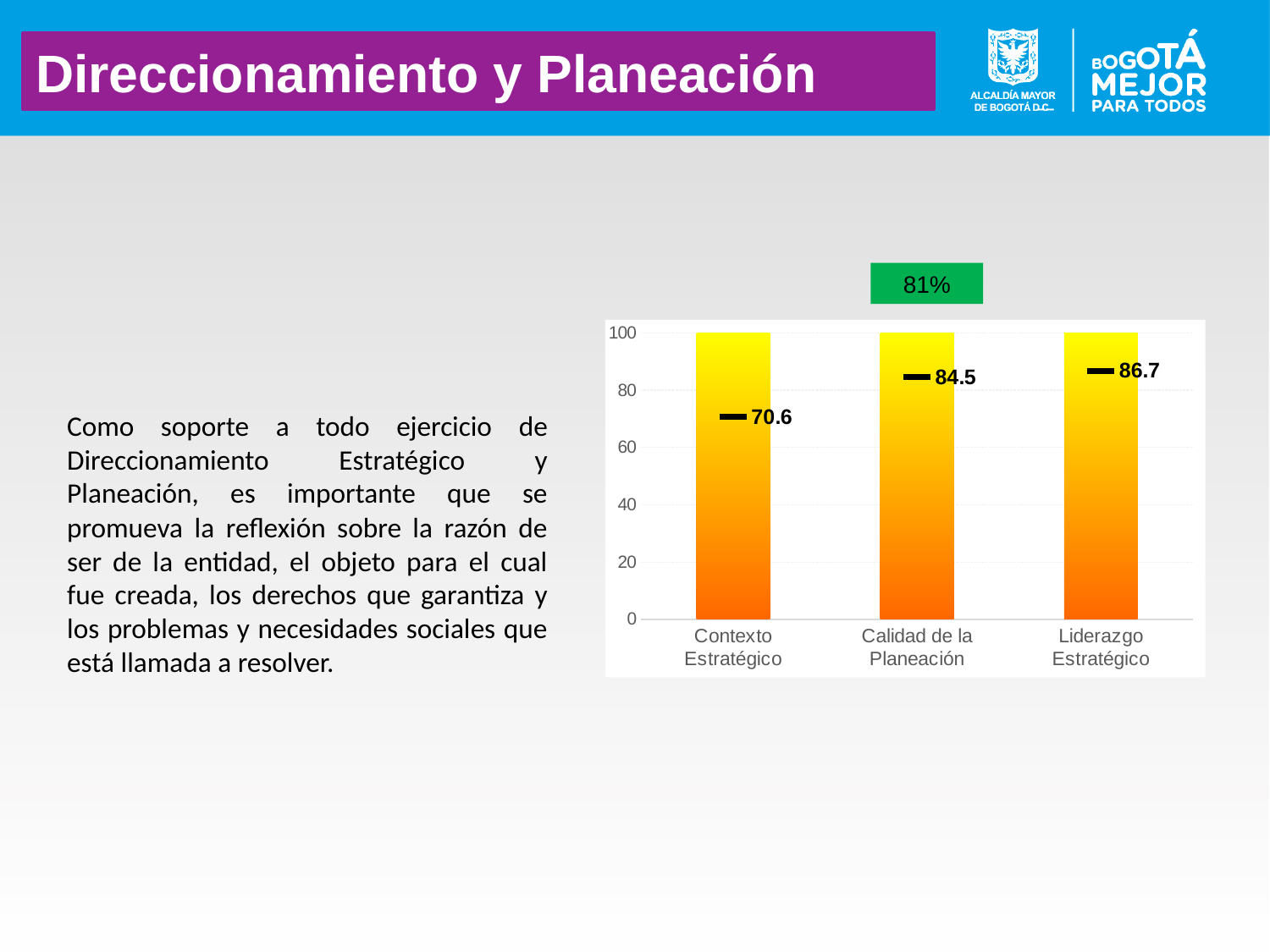
Which has a larger marked value, Calidad de la Planeación or Liderazgo Estratégico? Liderazgo Estratégico What is the difference between the marked values for Calidad de la Planeación and Contexto Estratégico? 13.9 Which category has the lowest marked value? Contexto Estratégico What is the difference between the marked values for Liderazgo Estratégico and Contexto Estratégico? 16.1 What is the value marked for Liderazgo Estratégico? 86.7 What is the value marked for Contexto Estratégico? 70.6 Is the marked value for Contexto Estratégico greater or less than 60? greater Do the marked values rise or fall from left to right across the categories? rise How many categories are shown on the x axis of the chart? 3 What percentage is shown in the green box above the chart? 81% What is the value marked for Calidad de la Planeación? 84.5 Which category has the highest marked value? Liderazgo Estratégico